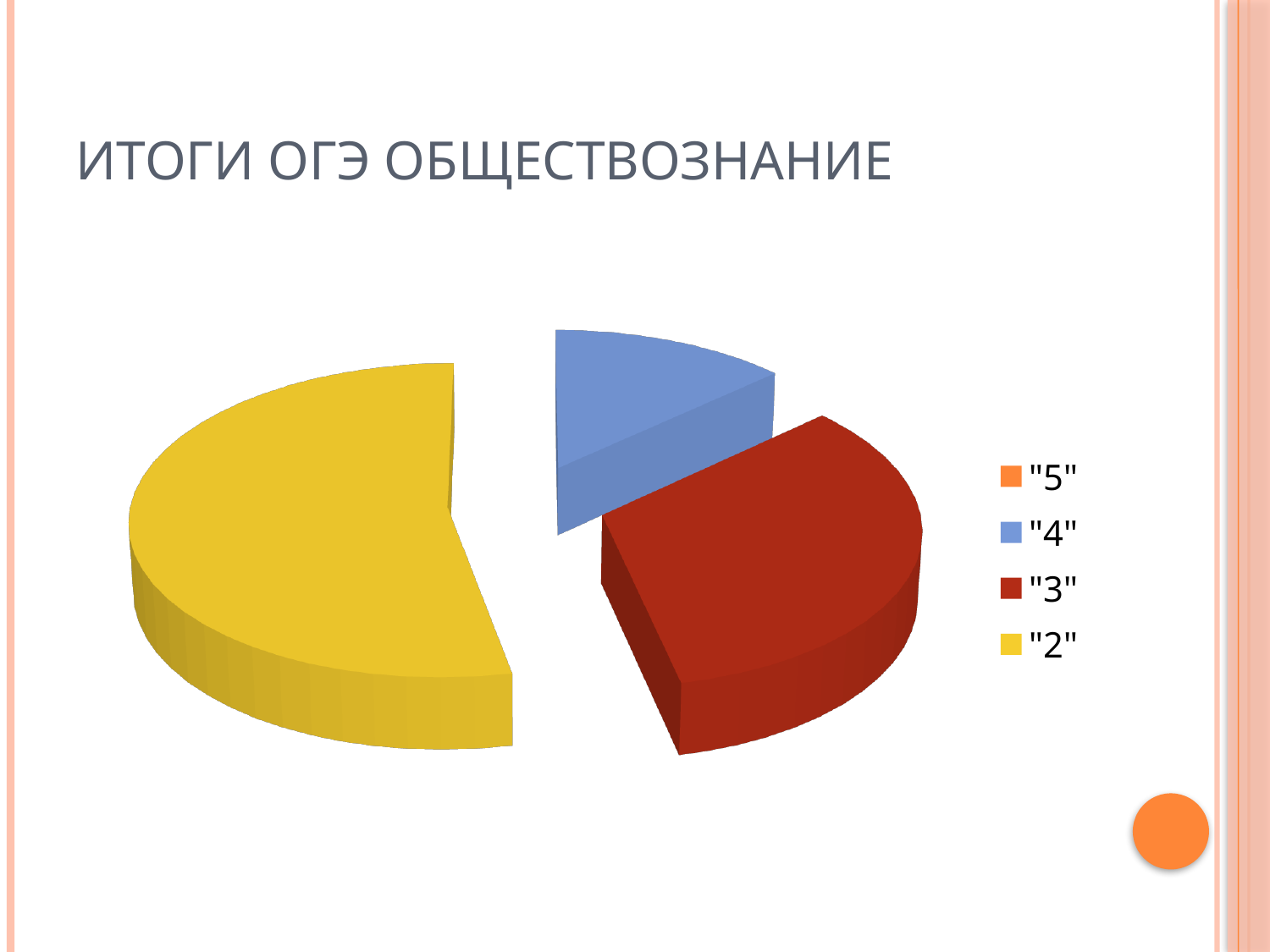
Which category has the largest slice of the pie? "2" How many slices are visibly drawn in the pie? 3 Which slice is larger, "2" or "4"? "2" Which slice is larger, "3" or "4"? "3" Which of the visible slices is the smallest? "4" What kind of chart is shown on the slide? pie chart How many entries does the chart legend list? 4 What is the title of the chart on the slide? ИТОГИ ОГЭ ОБЩЕСТВОЗНАНИЕ What colour is the slice for category "3"? red Which slice is larger, "2" or "3"? "2"